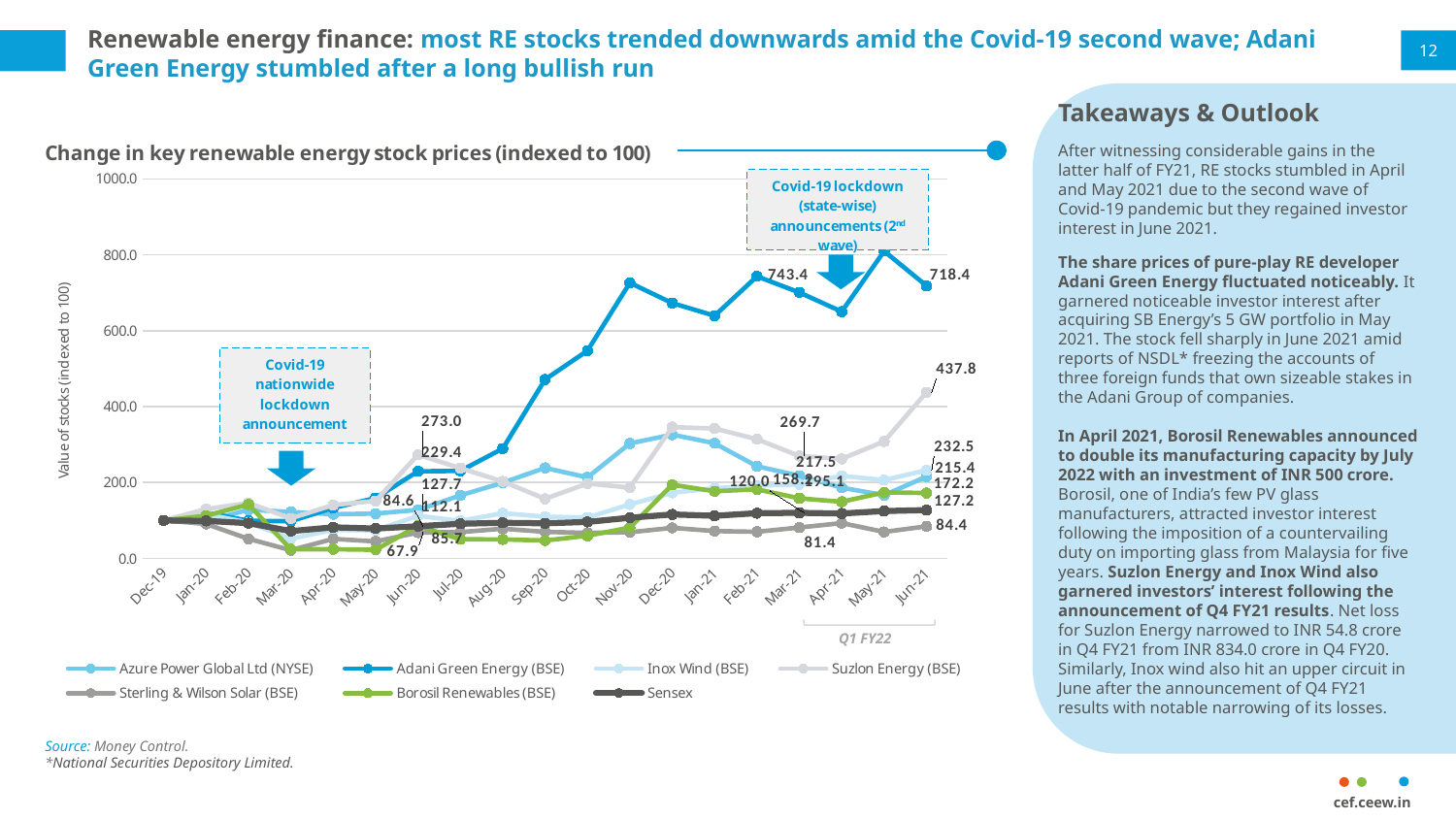
What is the indexed value of Suzlon Energy (BSE) in Jun-21? 437.8 What is the difference between Adani Green Energy's value in Feb-21 (743.4) and in Jun-21 (718.4)? 25.0 What is the title of the chart? Change in key renewable energy stock prices (indexed to 100) What type of chart is shown on the slide? Line chart What is the indexed value of Adani Green Energy (BSE) in Feb-21? 743.4 Which series has the lowest value in Jun-21? Sterling & Wilson Solar (BSE) What is the indexed value of Adani Green Energy (BSE) in Jun-21? 718.4 Is the value for Adani Green Energy (BSE) in Nov-20 greater or less than 600? greater In which month does the Adani Green Energy (BSE) line reach its peak? May-21 Which series has the highest value in Jun-21? Adani Green Energy (BSE) How many series does the chart legend list? 7 How many months are plotted along the x axis of the chart? 19